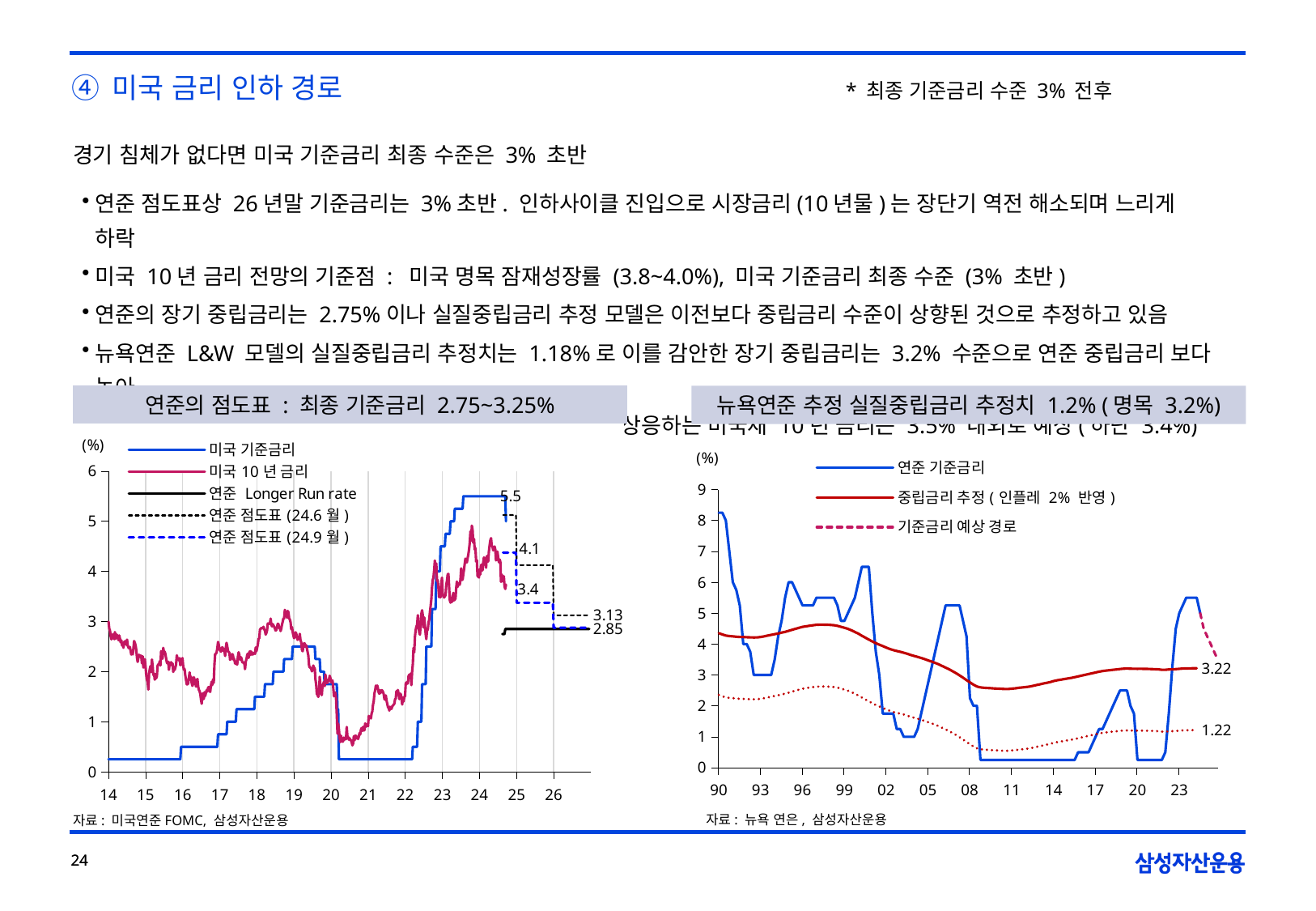
In the left chart, what value is labelled at the end of the 연준 점도표 (24.9월) line? 2.85 In the right chart, is the value of 연준 기준금리 in 1990 greater or less than 7? greater In the left chart, what is the difference between the labelled end values of the 연준 점도표 (24.6월) line (3.13) and the 연준 점도표 (24.9월) line (2.85)? 0.28 In the left chart, what is the labelled peak value of the 미국 기준금리 line? 5.5 In the left chart, which ends higher: the 연준 점도표 (24.6월) line or the 연준 점도표 (24.9월) line? 연준 점도표 (24.6월) What source is cited below the right chart? 뉴욕 연은, 삼성자산운용 How many series does the legend of the right chart (뉴욕연준 추정 실질중립금리 추정치) list? 3 In the left chart, what value is labelled at the end of the 연준 점도표 (24.6월) line? 3.13 How many series does the legend of the left chart (연준의 점도표) list? 5 In the right chart, what value is labelled at the end of the 중립금리 추정 (인플레 2% 반영) line? 3.22 In the left chart, is the value of 미국 기준금리 in 2021 greater or less than 1? less What kind of chart is the left chart titled '연준의 점도표 : 최종 기준금리 2.75~3.25%'? line chart